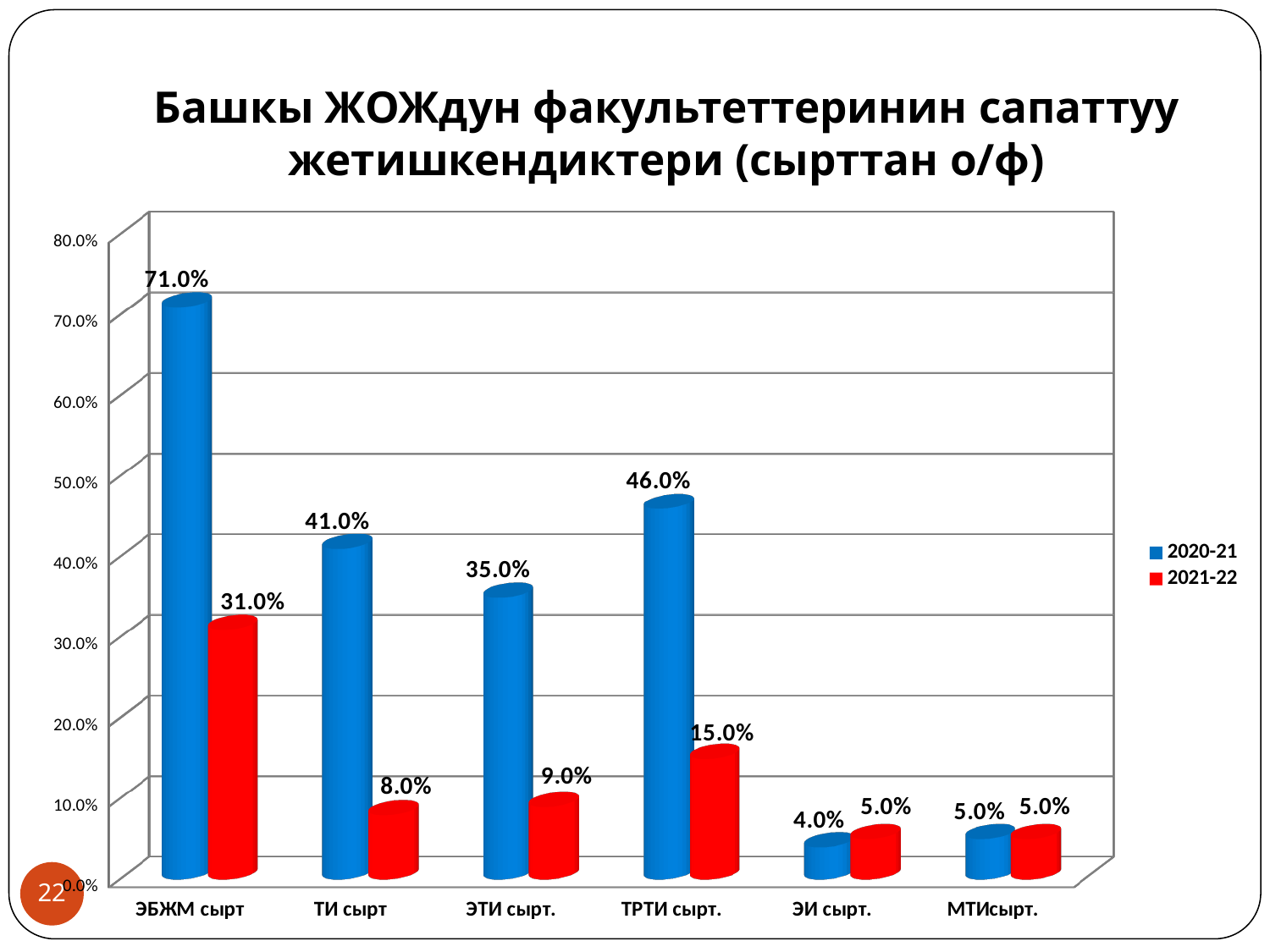
What is the difference between the 2020-21 values for ТРТИ сырт. and ТИ сырт? 5.0% Which category has the lowest 2020-21 value? ЭИ сырт. What kind of chart is shown on the slide? Bar chart What is the 2020-21 value for ЭБЖМ сырт? 71.0% Which is larger for ЭТИ сырт.: the 2020-21 value or the 2021-22 value? 2020-21 Which category has the highest 2020-21 value? ЭБЖМ сырт What is the difference between the 2020-21 and 2021-22 values for ЭБЖМ сырт? 40.0% Which colour represents the 2021-22 series? Red What is the 2021-22 value for ТРТИ сырт.? 15.0% How many series does the legend list? 2 How many categories are shown on the x axis? 6 What is the 2021-22 value for ТИ сырт? 8.0%